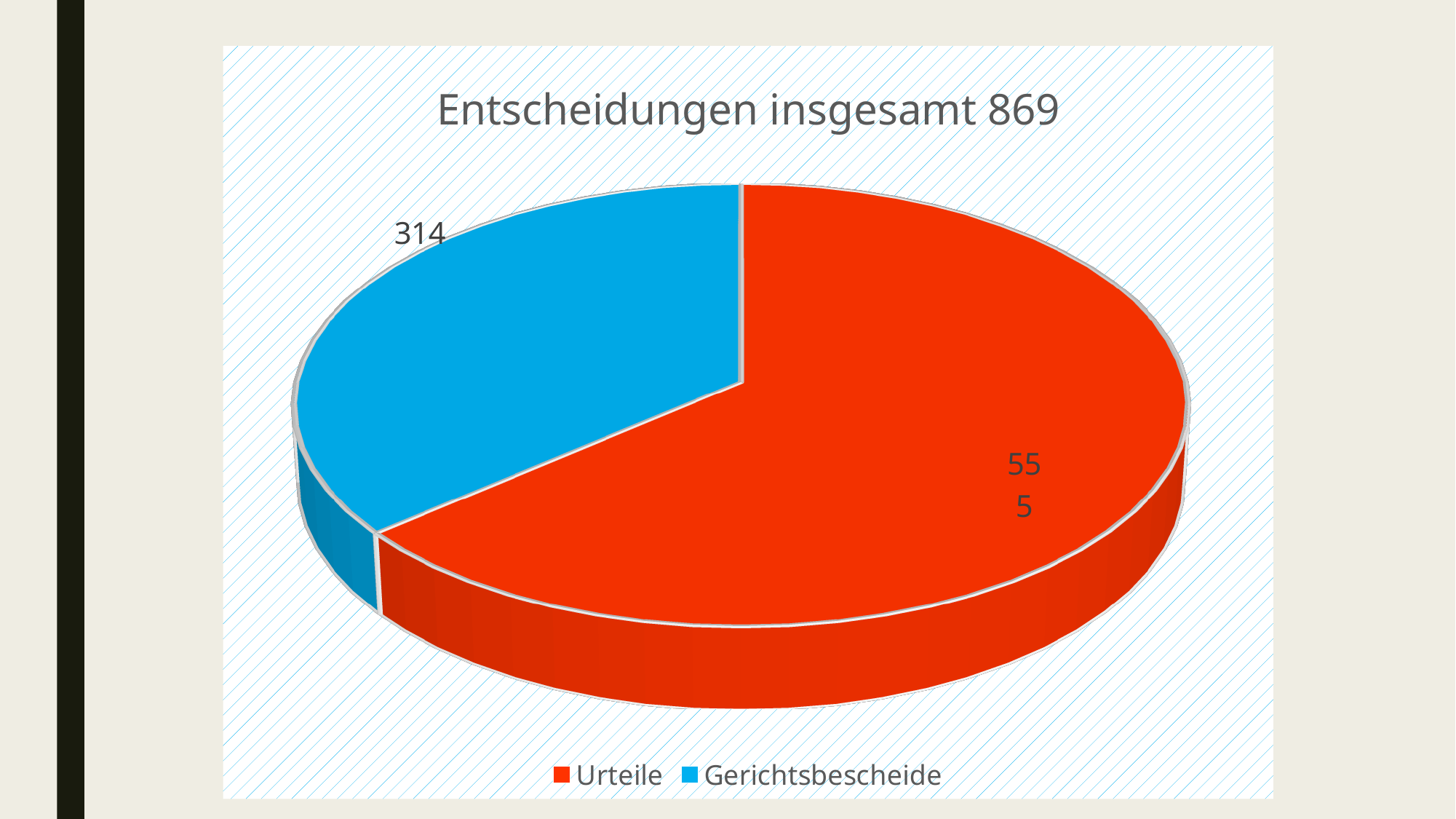
Which category has the smallest slice? Gerichtsbescheide Which is larger, Urteile or Gerichtsbescheide? Urteile What type of chart is shown on the slide? pie chart Which colour represents Gerichtsbescheide in the chart? blue What is the value for Urteile? 555 What is the title of the chart? Entscheidungen insgesamt 869 What is the total of the two slices in the pie chart? 869 What is the value for Gerichtsbescheide? 314 What is the difference between the values for Urteile and Gerichtsbescheide? 241 Which category has the largest slice? Urteile How many slices does the pie chart have? 2 How many entries does the legend list? 2